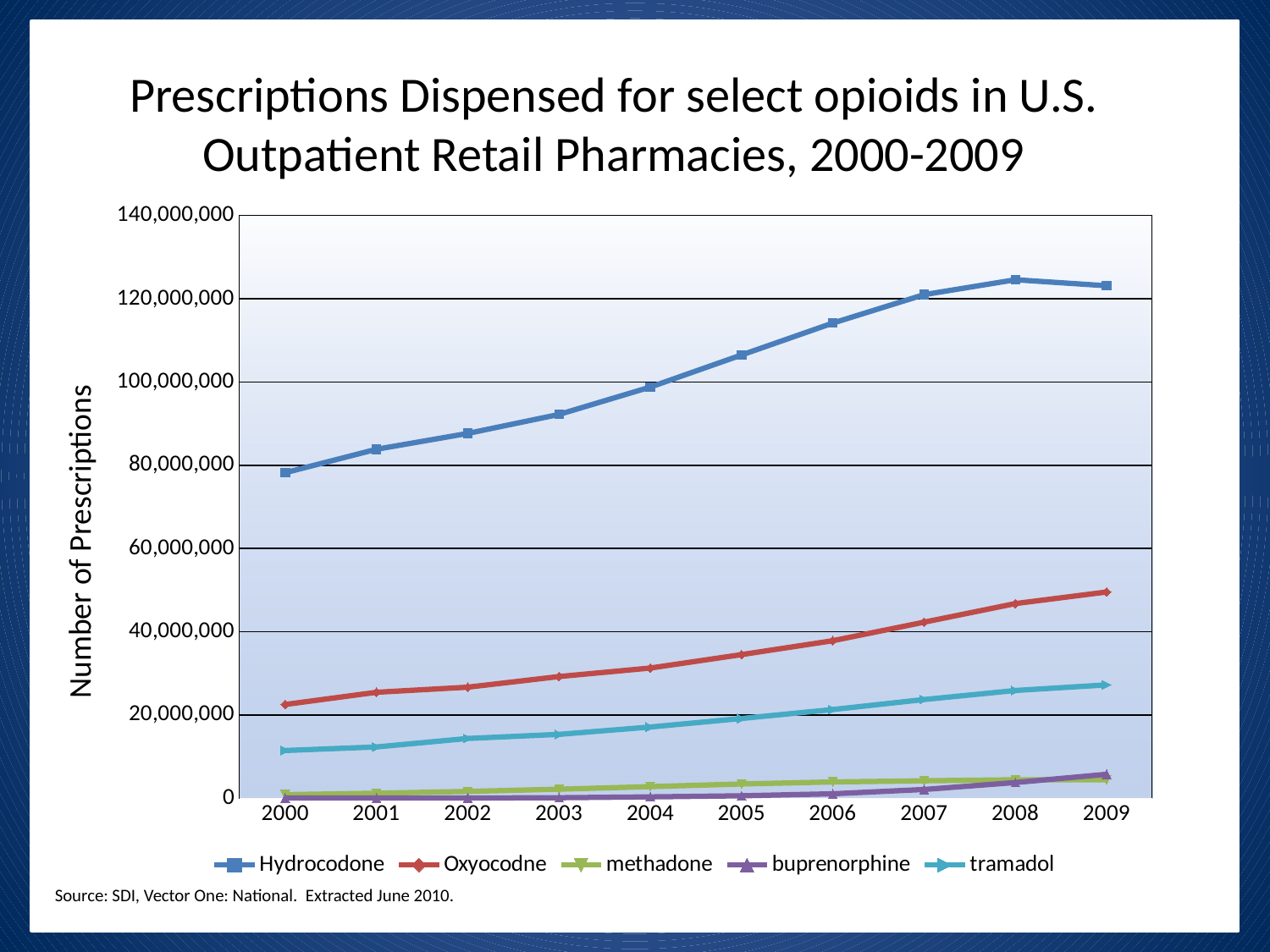
Which is larger in 2005, the value for Oxyocodne or the value for tramadol? Oxyocodne In which year does the Hydrocodone series reach its highest value? 2008 Which series has the highest number of prescriptions in 2009? Hydrocodone Is the value for tramadol in 2000 greater or less than 20,000,000? less What is the label on the y axis? Number of Prescriptions How many years are plotted along the x axis? 10 Do the values for Oxyocodne rise or fall from 2000 to 2009? rise Is the value for Hydrocodone in 2008 greater or less than 120,000,000? greater Which series has the lowest number of prescriptions in 2005? buprenorphine How many series does the legend list? 5 What kind of chart is shown on the slide? line chart Is the value for Oxyocodne in 2009 greater or less than 40,000,000? greater